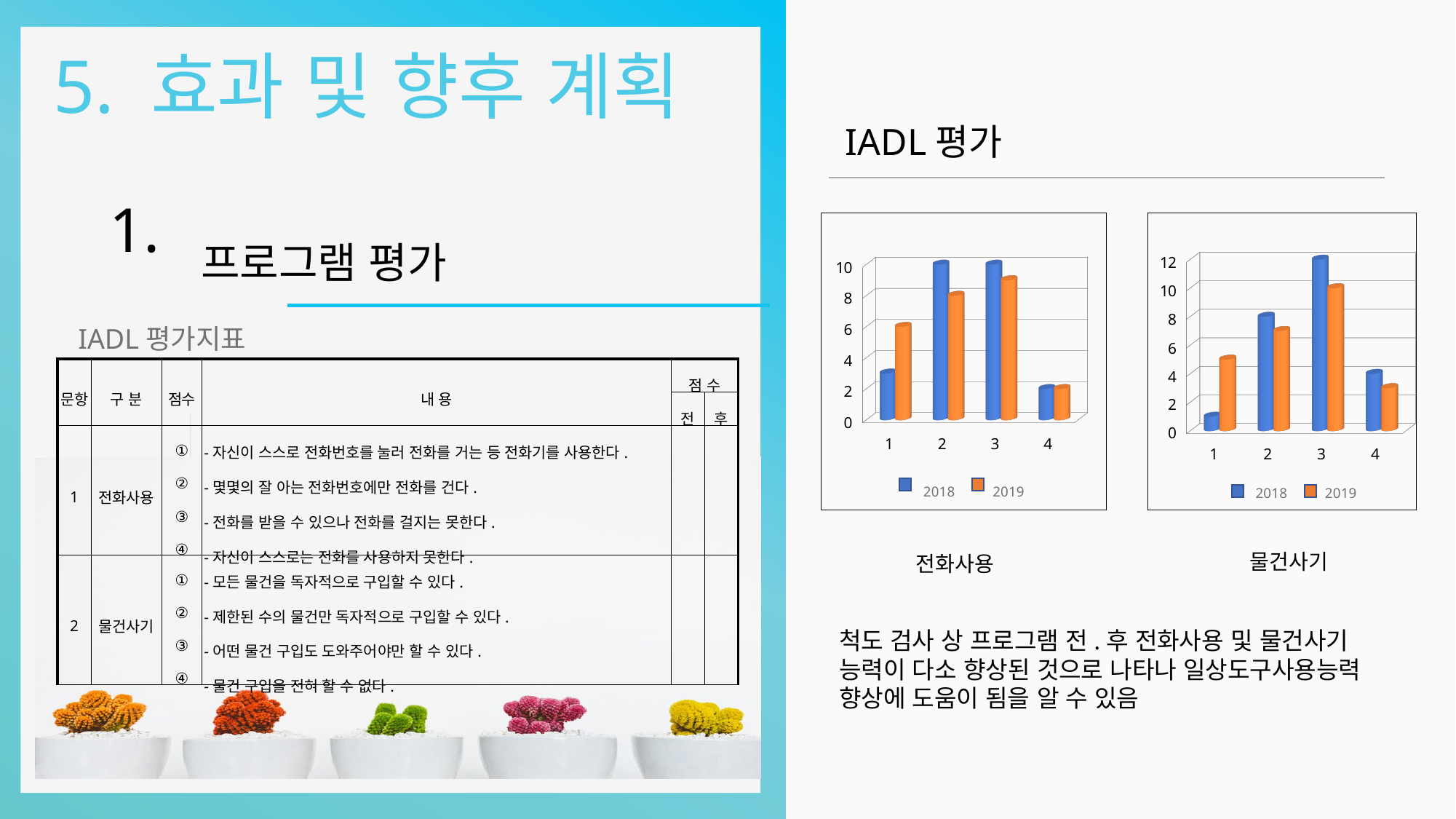
In the 물건사기 chart, is the 2018 value for category 3 greater or less than 10? greater What are the legend entries of the 전화사용 chart? 2018, 2019 In the 물건사기 chart, is the 2019 value for category 4 greater or less than 4? less How many series does the legend of the 물건사기 chart list? 2 In the 물건사기 chart, which category has the lowest 2018 value? 1 In the 전화사용 chart, is the 2018 value for category 4 greater or less than 4? less What kind of chart is the 전화사용 chart on the left? bar chart In the 전화사용 chart, which is larger for category 1, the 2018 value or the 2019 value? 2019 In the 물건사기 chart, which is larger for category 1, the 2018 value or the 2019 value? 2019 How many categories are shown on the x axis of the 물건사기 chart? 4 In the 물건사기 chart, which category has the highest 2018 value? 3